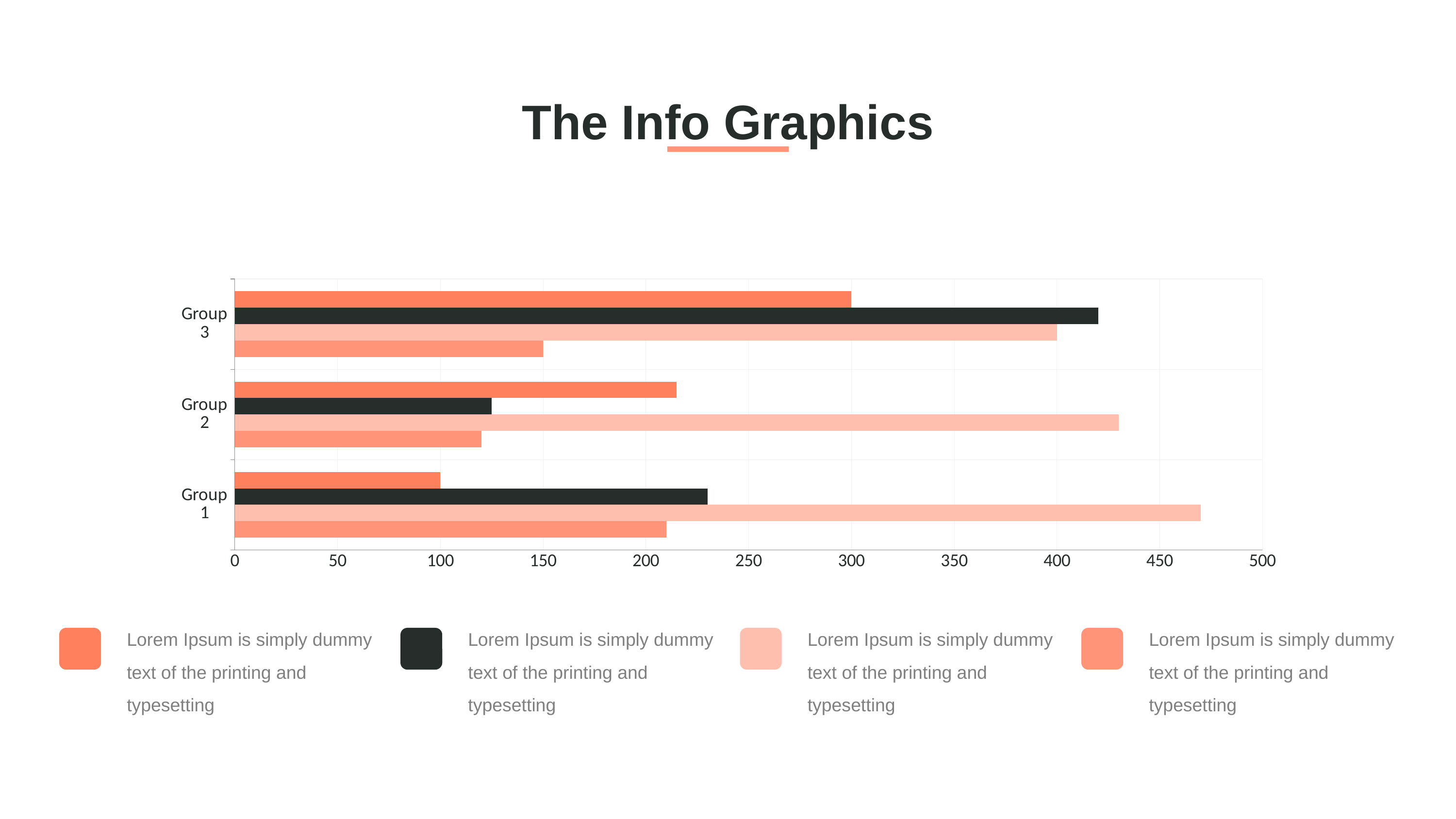
What is the difference between the topmost bar and the bottom bar for Group 3? 150 What is the value of the topmost bar for Group 3? 300 What is the value of the light peach (third) bar for Group 3? 400 How many series does the legend below the chart list? 4 What is the value of the bottom bar for Group 3? 150 How many groups (categories) are plotted on the chart? 3 Is the value of the light peach bar for Group 1 greater or less than 450? greater What kind of chart is shown on the slide? bar chart What is the value of the topmost bar for Group 1? 100 For Group 1, which is larger: the dark bar or the topmost bar? the dark bar What is the title of the slide? The Info Graphics Which group has the longest dark (second) bar? Group 3